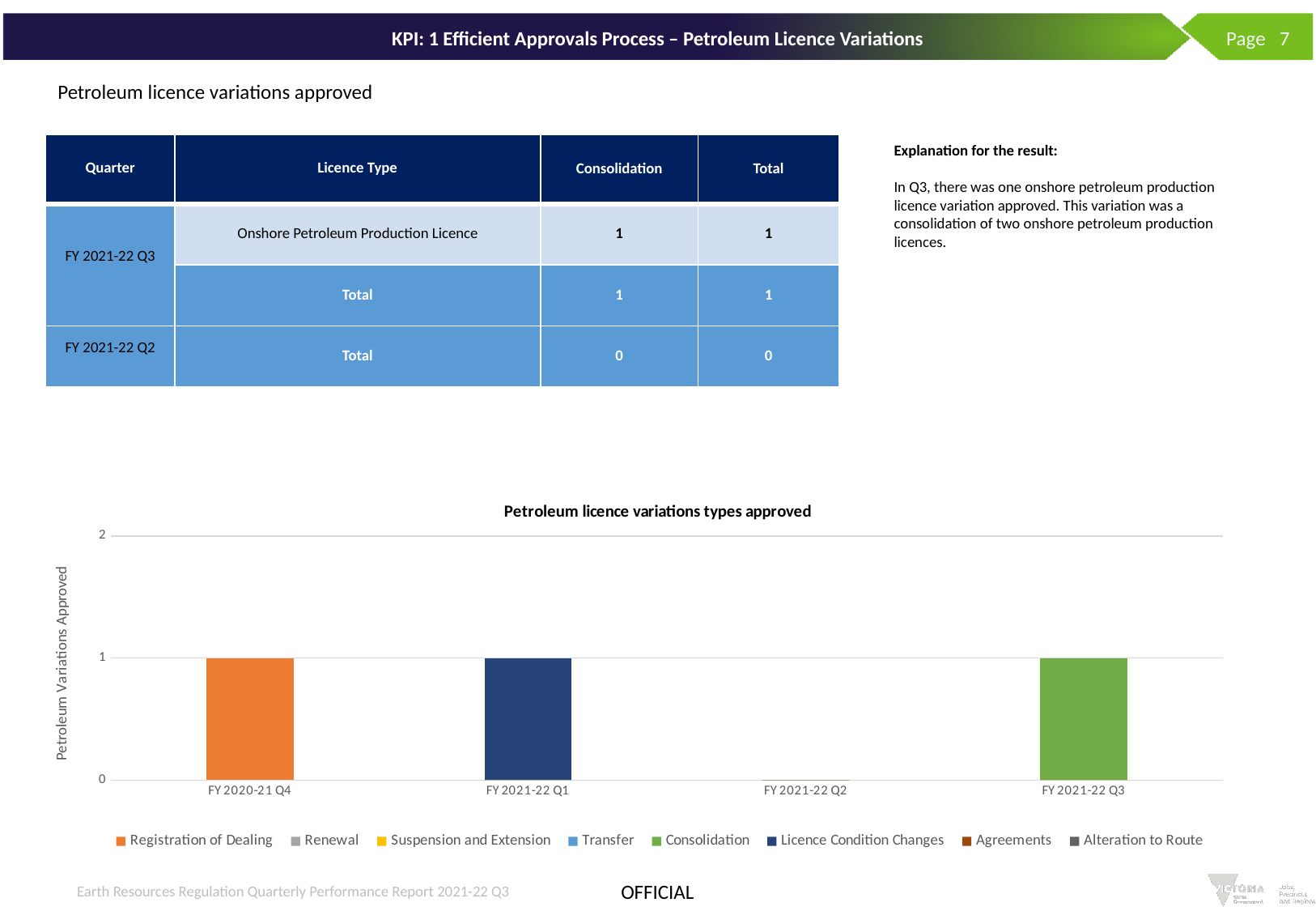
Which series is plotted for FY 2021-22 Q3? Consolidation Which is larger, the value for FY 2020-21 Q4 or the value for FY 2021-22 Q2? FY 2020-21 Q4 What type of chart is shown on the slide? bar chart How many series does the chart legend list? 8 Which quarter on the chart has no petroleum variations approved? FY 2021-22 Q2 What is the value of the Registration of Dealing bar for FY 2020-21 Q4? 1 Is the value for FY 2021-22 Q1 greater or less than 2? less How many quarters are shown on the x axis of the chart? 4 What is the title of the chart? Petroleum licence variations types approved What is the value of the Consolidation bar for FY 2021-22 Q3? 1 What is the difference between the value for FY 2021-22 Q3 and the value for FY 2021-22 Q2? 1 What is the value of the Licence Condition Changes bar for FY 2021-22 Q1? 1